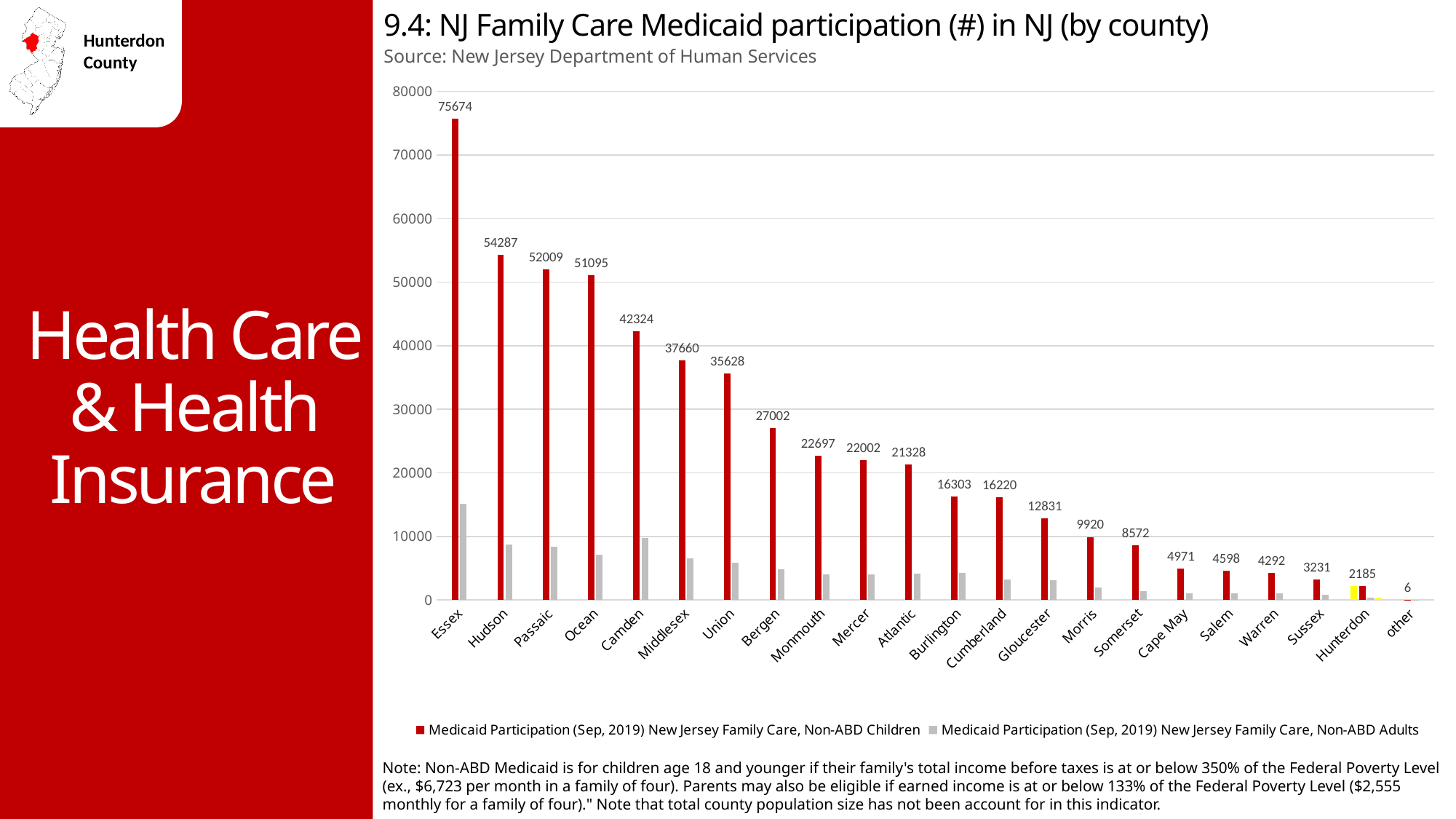
Which county has the highest Non-ABD Children Medicaid participation? Essex What kind of chart is shown on the slide? bar chart Do the Non-ABD Children values rise or fall from left to right along the x axis? fall What is the difference between the Non-ABD Children values for Hudson and Passaic? 2278 What is the Non-ABD Children Medicaid participation value for Bergen? 27002 How many series does the legend list? 2 What is the Non-ABD Children Medicaid participation value for Essex? 75674 Which has a larger Non-ABD Children value, Camden or Middlesex? Camden Is the Non-ABD Adults value for Essex greater or less than 10000? greater What is the Non-ABD Children Medicaid participation value for Hunterdon? 2185 Which category has the lowest Non-ABD Children Medicaid participation? other How many categories are shown on the x axis? 22